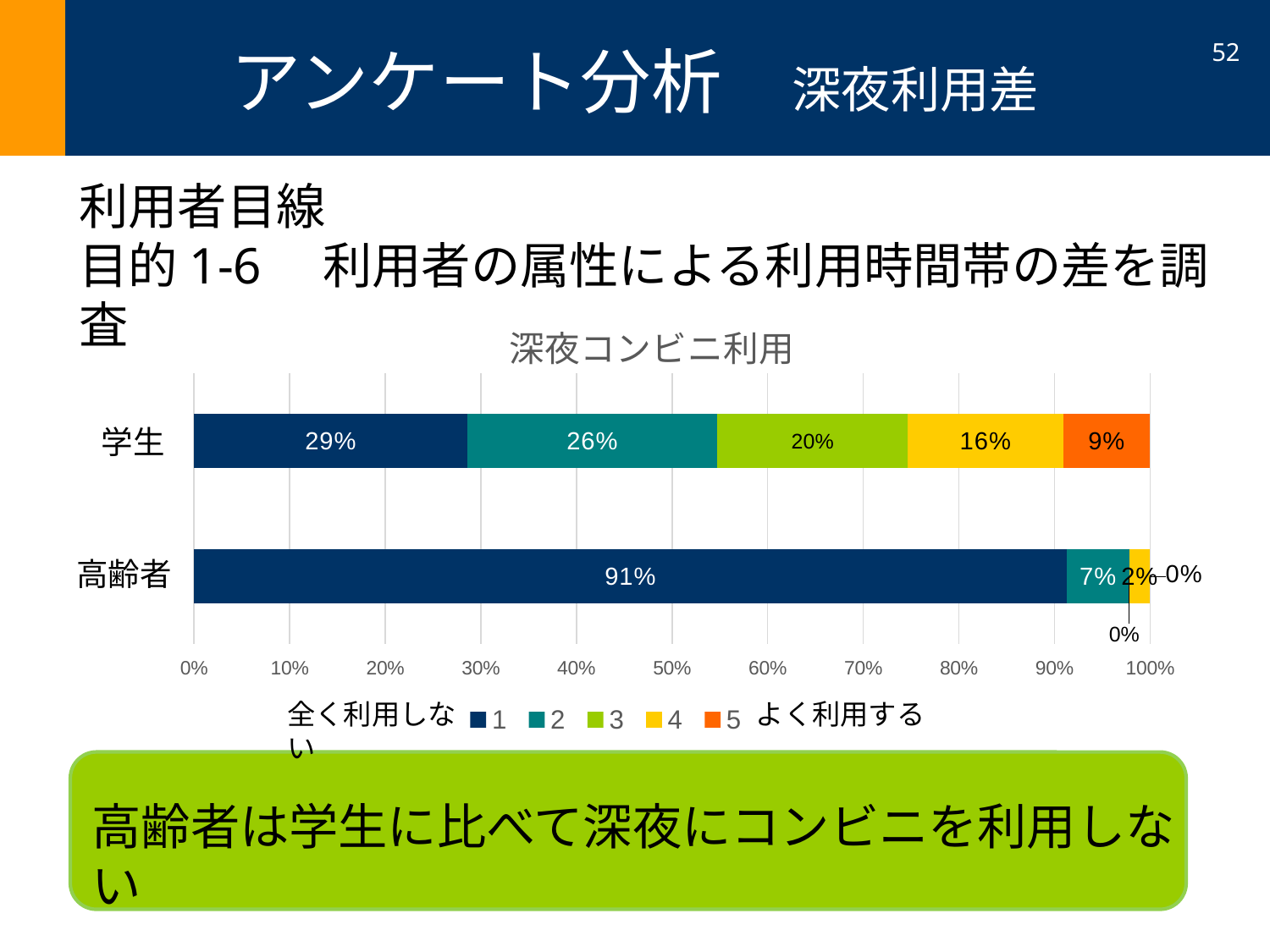
Which series has the lowest value for 学生? 5 What is the value of series 1 for 高齢者? 91% What is the value of series 1 for 学生? 29% Which series has the highest value for 学生? 1 Which is larger: series 3 for 学生 or series 3 for 高齢者? 学生 How many series does the legend list? 5 What type of chart is shown on the slide? stacked bar chart What is the title of the chart? 深夜コンビニ利用 What is the difference between the series 1 values for 高齢者 and 学生? 62% What is the value of series 5 for 学生? 9% How many categories are shown on the vertical axis of the chart? 2 What is the value of series 2 for 高齢者? 7%